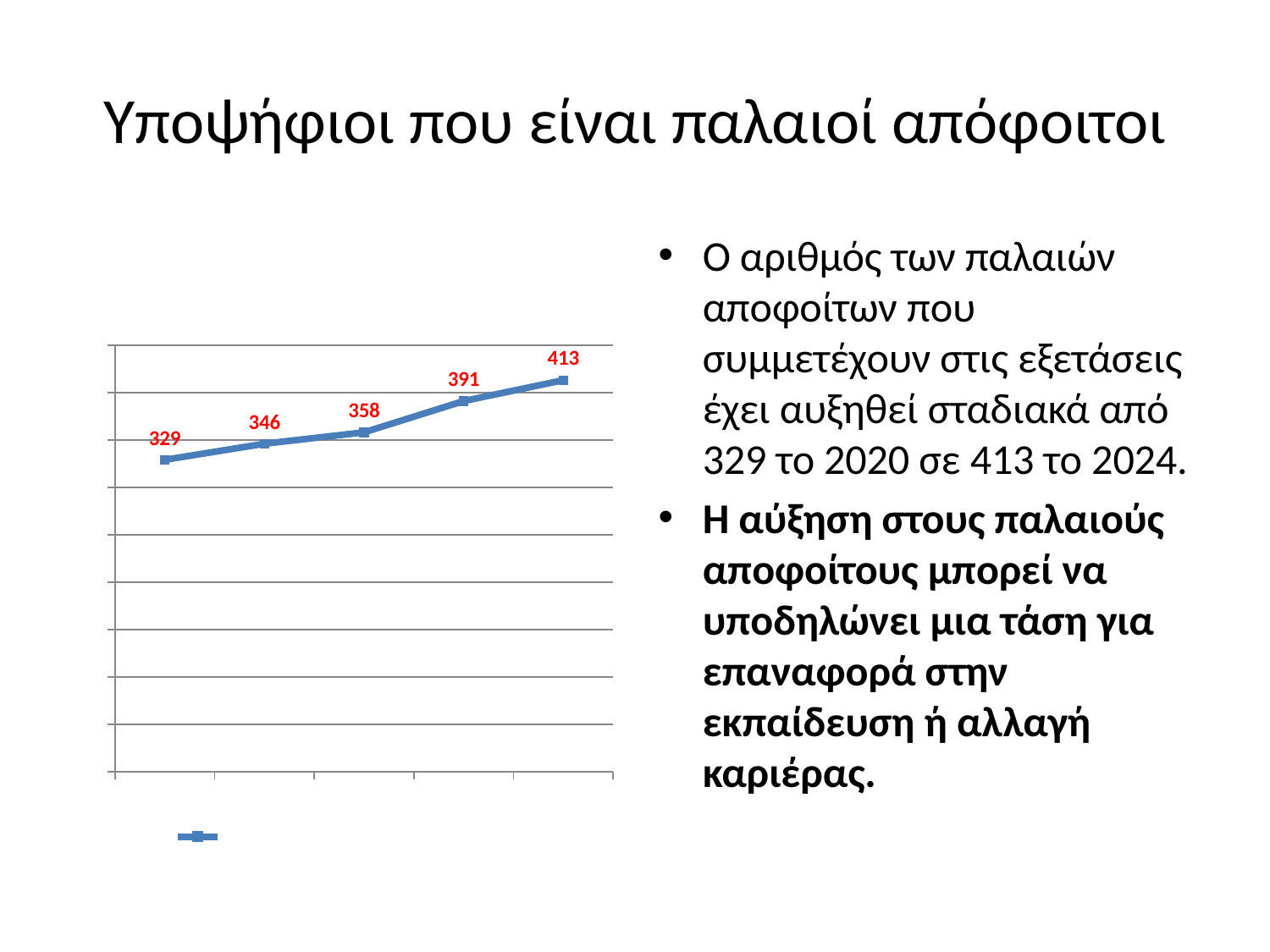
What is the value of the last (rightmost) point on the line? 413 What is the value of the fourth point on the line? 391 What is the difference between the last value (413) and the first value (329)? 84 Which is larger, the second point or the third point on the line? the third point (358) What is the value of the first (leftmost) point on the line? 329 How many data points are plotted on the line? 5 What is the difference between the fourth point (391) and the third point (358)? 33 What is the highest value shown on the chart? 413 Do the values rise or fall from left to right along the x axis? rise What is the lowest value shown on the chart? 329 What is the value of the third point on the line? 358 What kind of chart is shown on the slide? line chart